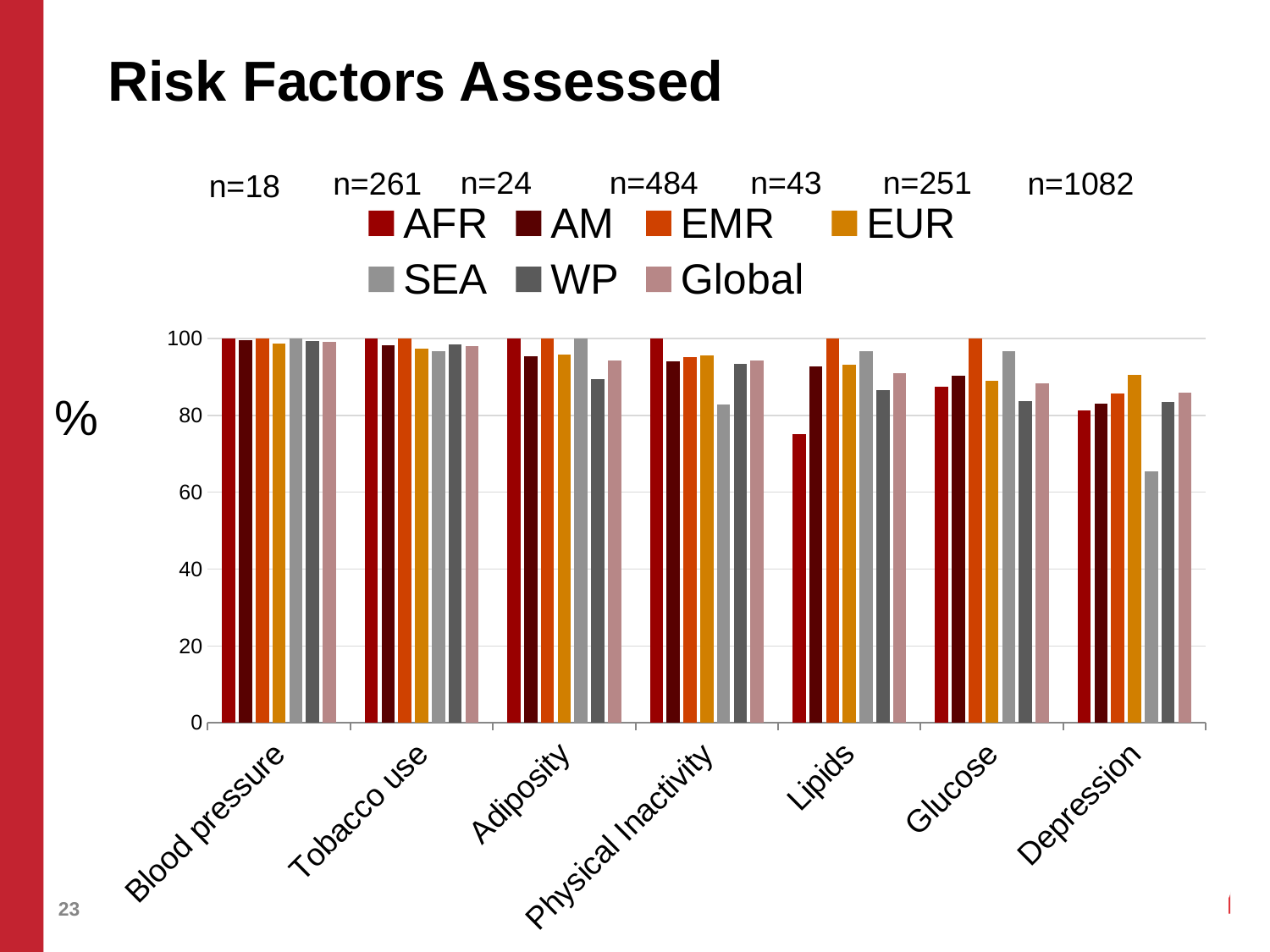
Is the value for AFR in the Lipids category greater or less than 80? less What kind of chart is shown on the slide? bar chart Which series has the lowest value for Depression? SEA What is the value for AFR in the Blood pressure category? 100 What is the title of the chart? Risk Factors Assessed Which series has the lowest value for Lipids? AFR How many risk factor categories are shown on the x axis? 7 For Lipids, which is larger: the AFR value or the EMR value? EMR Is the value for SEA in the Depression category greater or less than 80? less Is the value for WP in the Adiposity category greater or less than 80? greater How many series does the legend list? 7 What label is shown on the vertical axis? %